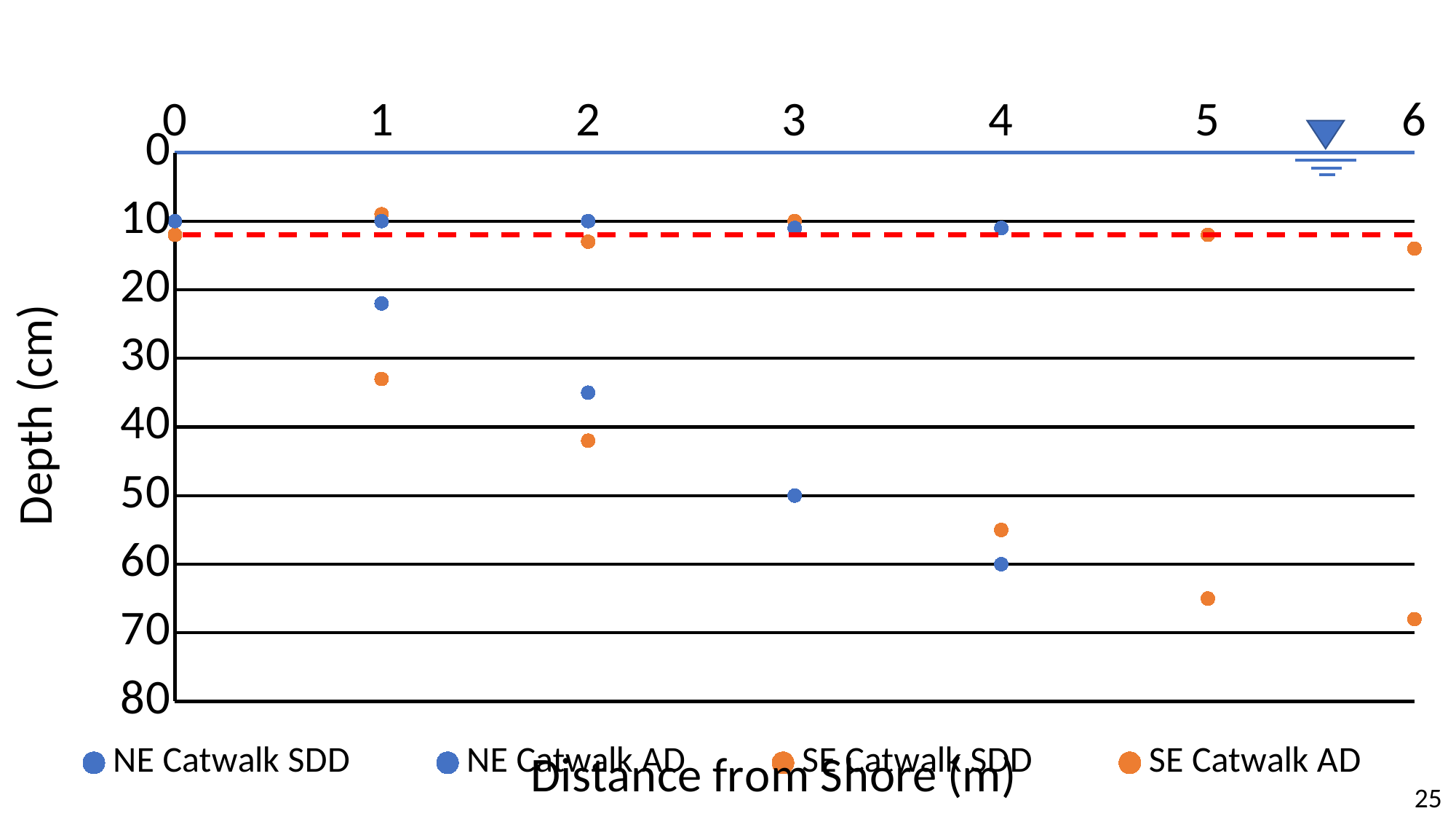
At 2 m from shore, which is deeper: the deepest blue point or the deepest orange point? the deepest orange point What depth does the deepest blue point at 3 m from shore land on? 50 How many series does the legend list? 4 What kind of chart is shown on the slide? scatter chart What is the title of the horizontal axis? Distance from Shore (m) Do the deepest orange points get deeper or shallower as distance from shore increases? deeper At 4 m from shore, which is deeper: the deepest blue point or the deepest orange point? the deepest blue point Is the depth of the deepest orange point at 1 m from shore greater or less than 40? less Is the depth of the deepest orange point at 6 m from shore greater or less than 60? greater Is the depth of the deepest blue point at 2 m from shore greater or less than 30? greater What depth does the deepest blue point at 4 m from shore land on? 60 What is the title of the vertical axis? Depth (cm)